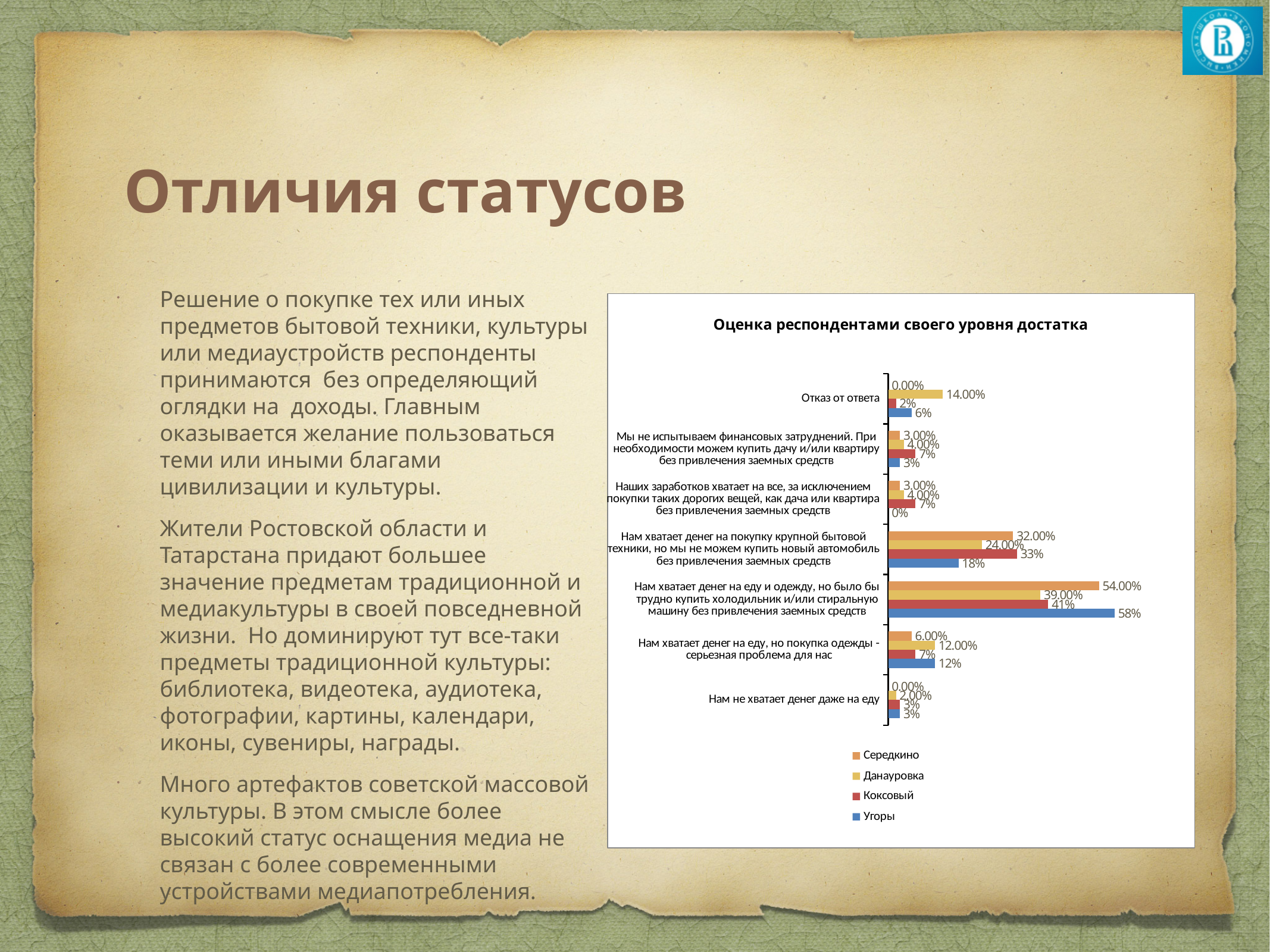
What is the value for Коксовый in the category "Нам не хватает денег даже на еду"? 3% What is the difference between the Угоры and Середкино values in the category "Нам хватает денег на еду и одежду, но было бы трудно купить холодильник и/или стиральную машину без привлечения заемных средств"? 4% In the category "Нам хватает денег на еду, но покупка одежды - серьезная проблема для нас", which is larger: the value for Данауровка or the value for Середкино? Данауровка Which series has the lowest value in the category "Нам хватает денег на покупку крупной бытовой техники, но мы не можем купить новый автомобиль без привлечения заемных средств"? Угоры What kind of chart is shown on the slide? bar chart What is the value for Середкино in the category "Нам хватает денег на покупку крупной бытовой техники, но мы не можем купить новый автомобиль без привлечения заемных средств"? 32.00% Which category has the highest value for Середкино? Нам хватает денег на еду и одежду, но было бы трудно купить холодильник и/или стиральную машину без привлечения заемных средств How many series does the legend of the chart list? 4 What is the value for Данауровка in the category "Отказ от ответа"? 14.00% What is the value for Угоры in the category "Нам хватает денег на еду и одежду, но было бы трудно купить холодильник и/или стиральную машину без привлечения заемных средств"? 58% How many categories are shown on the chart? 7 What is the title of the chart? Оценка респондентами своего уровня достатка